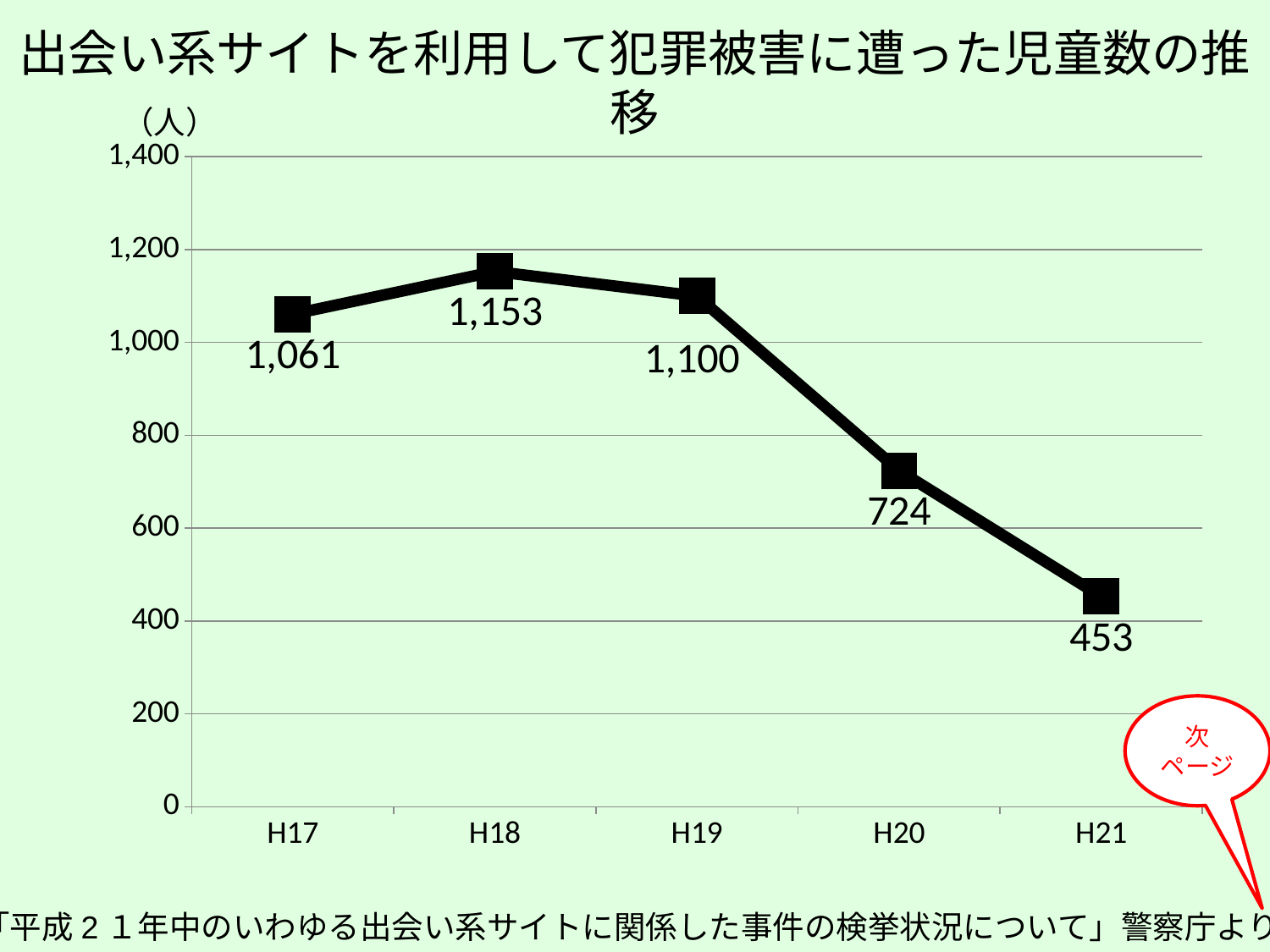
What unit is shown at the top of the y axis? （人） Which year has the highest value? H18 How many years are plotted on the x axis? 5 Which year has the lowest value? H21 What is the value for H17? 1,061 Which is larger, the value for H17 or the value for H19? H19 What is the value for H20? 724 What is the difference between the values for H19 and H20? 376 What is the value for H21? 453 Do the values rise or fall from H19 to H21? fall What kind of chart is this? line chart What is the difference between the values for H18 and H21? 700